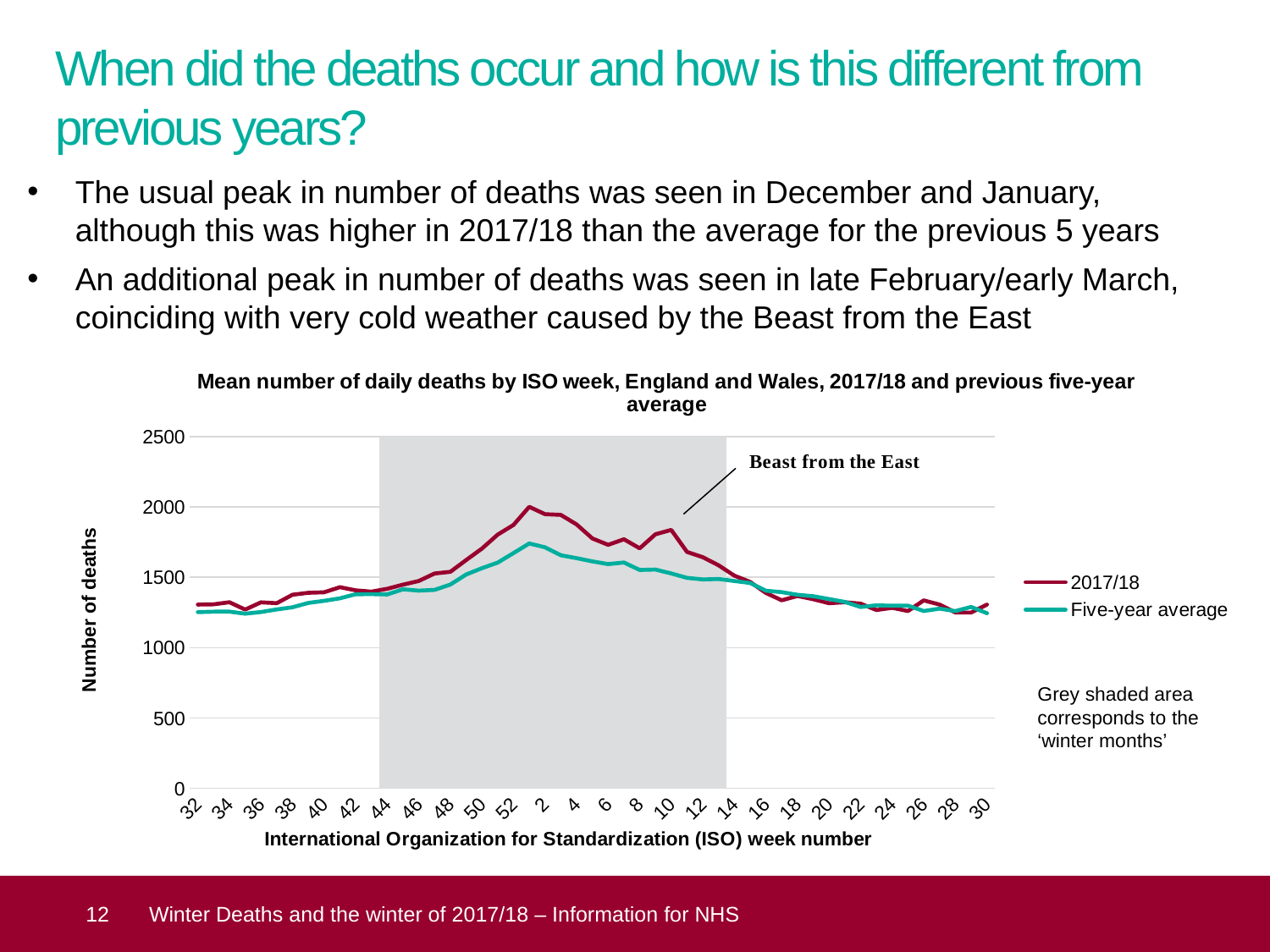
Does the Five-year average line rise or fall between ISO week 2 and ISO week 30? Fall Does the 2017/18 line rise or fall between ISO week 32 and ISO week 52? Rise Is the 2017/18 value at ISO week 10 greater or less than 2000? less What kind of chart is shown on the slide? Line chart Is the 2017/18 value at ISO week 2 greater or less than 1500? greater What is the title of the chart? Mean number of daily deaths by ISO week, England and Wales, 2017/18 and previous five-year average Is the Five-year average value at ISO week 32 greater or less than 1500? less What are the two series named in the legend? 2017/18 and Five-year average Which series reaches the highest peak on the chart? 2017/18 At ISO week 2, which series has the larger value, 2017/18 or Five-year average? 2017/18 How many series does the legend list? 2